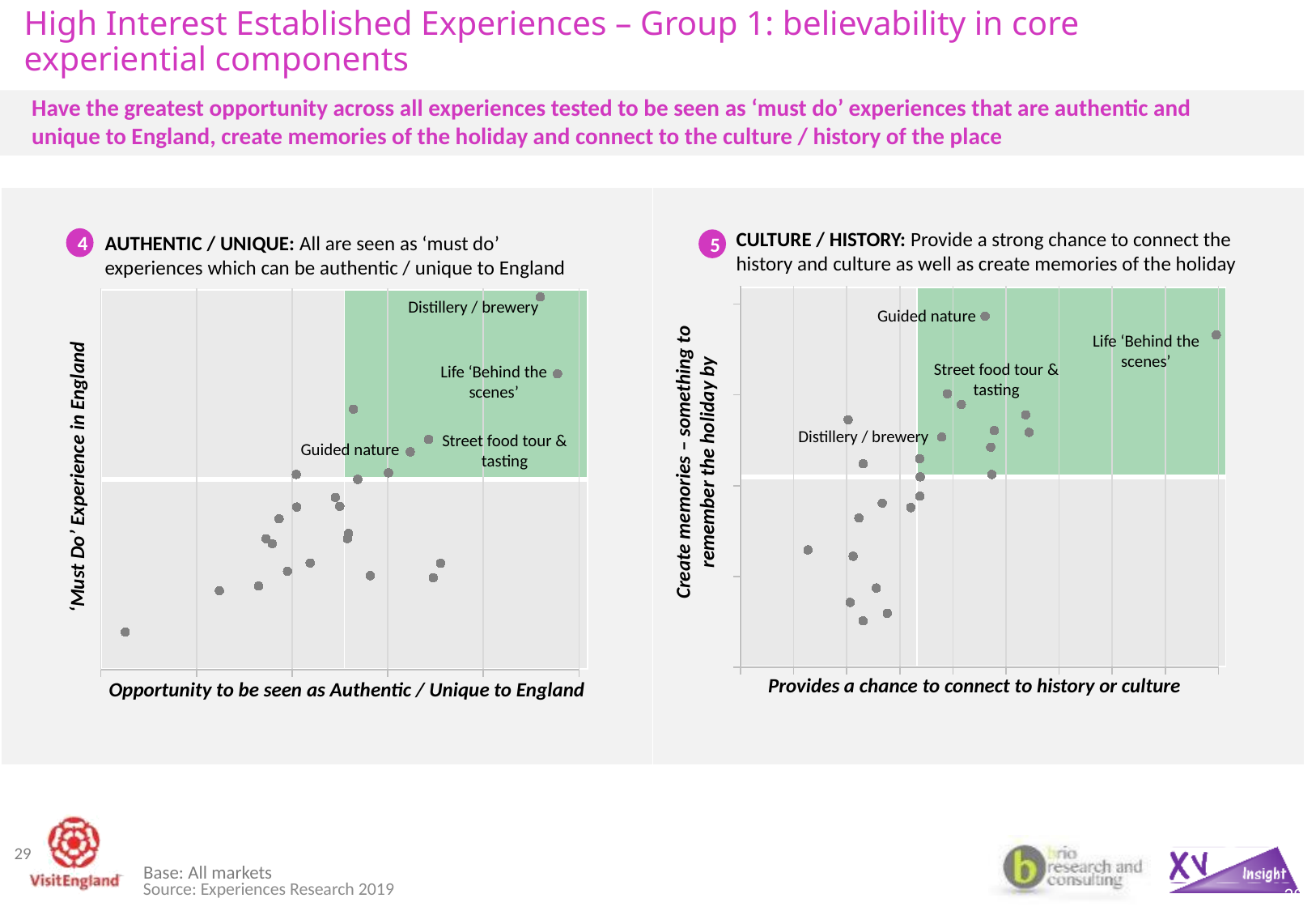
In the CULTURE / HISTORY chart on the right, which labelled experience is furthest right on the Provides a chance to connect to history or culture axis? Life 'Behind the scenes' What kind of chart is the AUTHENTIC / UNIQUE chart on the left? Scatter chart What kind of chart is the CULTURE / HISTORY chart on the right? Scatter chart In the CULTURE / HISTORY chart on the right, what is the title of the vertical axis? Create memories – something to remember the holiday by In the AUTHENTIC / UNIQUE chart on the left, what is the title of the horizontal axis? Opportunity to be seen as Authentic / Unique to England In the CULTURE / HISTORY chart on the right, how many points are labelled with an experience name? 4 In the AUTHENTIC / UNIQUE chart on the left, which labelled experience is highest on the 'Must Do' Experience in England axis? Distillery / brewery In the AUTHENTIC / UNIQUE chart on the left, how many points are labelled with an experience name? 4 In the CULTURE / HISTORY chart on the right, which labelled experience is lowest on the Create memories axis? Distillery / brewery How many charts are shown on the slide? 2 In the AUTHENTIC / UNIQUE chart on the left, which is further right on the Opportunity to be seen as Authentic / Unique axis: Distillery / brewery or Guided nature? Distillery / brewery In the CULTURE / HISTORY chart on the right, which labelled experience is highest on the Create memories axis? Guided nature